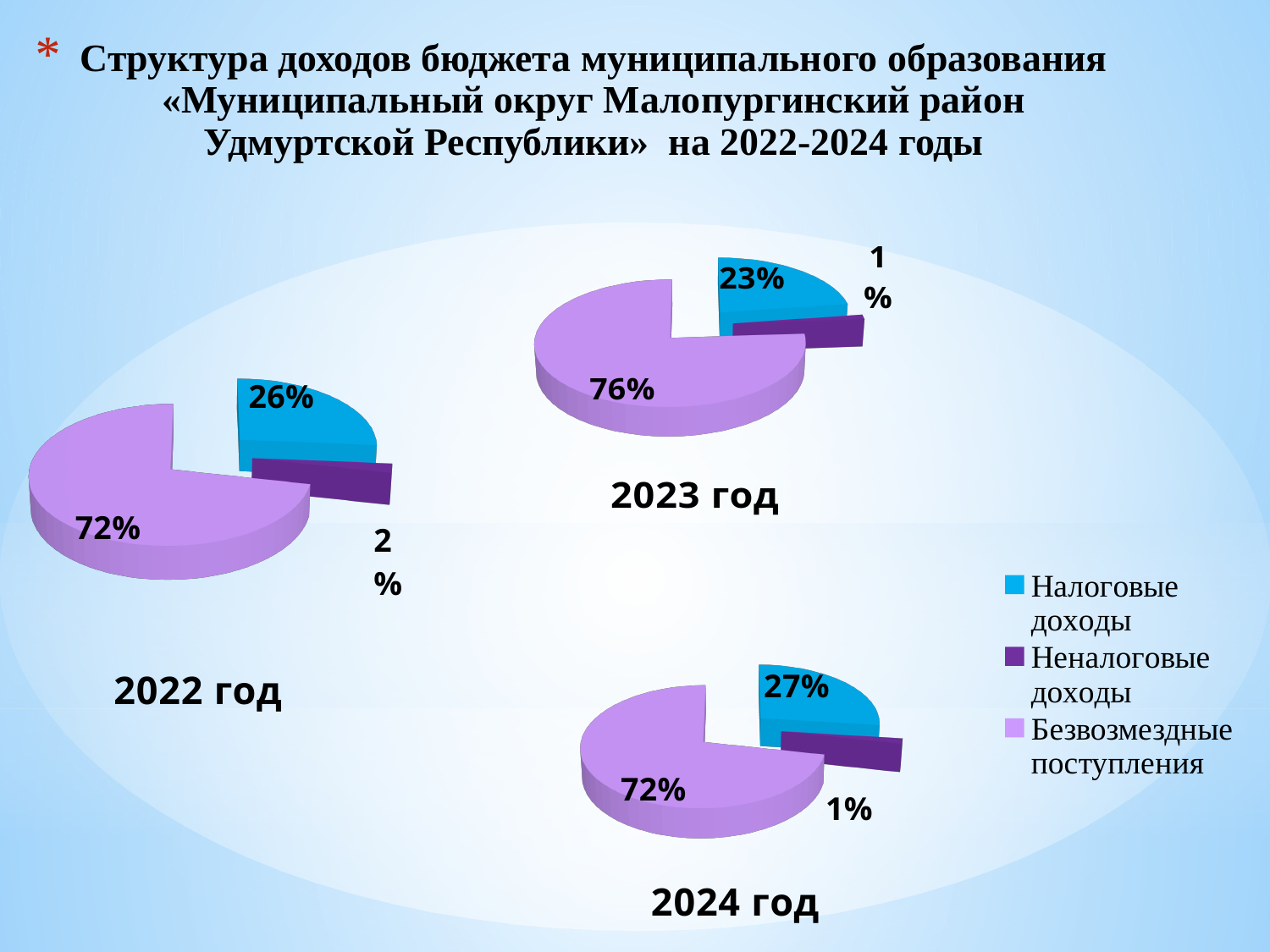
In the 2024 год pie chart, which category has the largest slice? Безвозмездные поступления How many pie charts are shown on the slide? 3 In the 2022 год pie chart, what share is Налоговые доходы? 26% In the 2023 год pie chart, what is the difference between the Безвозмездные поступления share and the Налоговые доходы share? 53% What type of chart is used for 2022 год? Pie chart In the 2022 год pie chart, which category has the smallest slice? Неналоговые доходы In the 2024 год pie chart, what share is Налоговые доходы? 27% How many categories does the legend list? 3 In the 2023 год pie chart, what share is Безвозмездные поступления? 76% In the 2023 год pie chart, what share is Неналоговые доходы? 1% Which is larger: the Налоговые доходы share in 2024 год or in 2023 год? 2024 год In the 2022 год pie chart, what share is Безвозмездные поступления? 72%